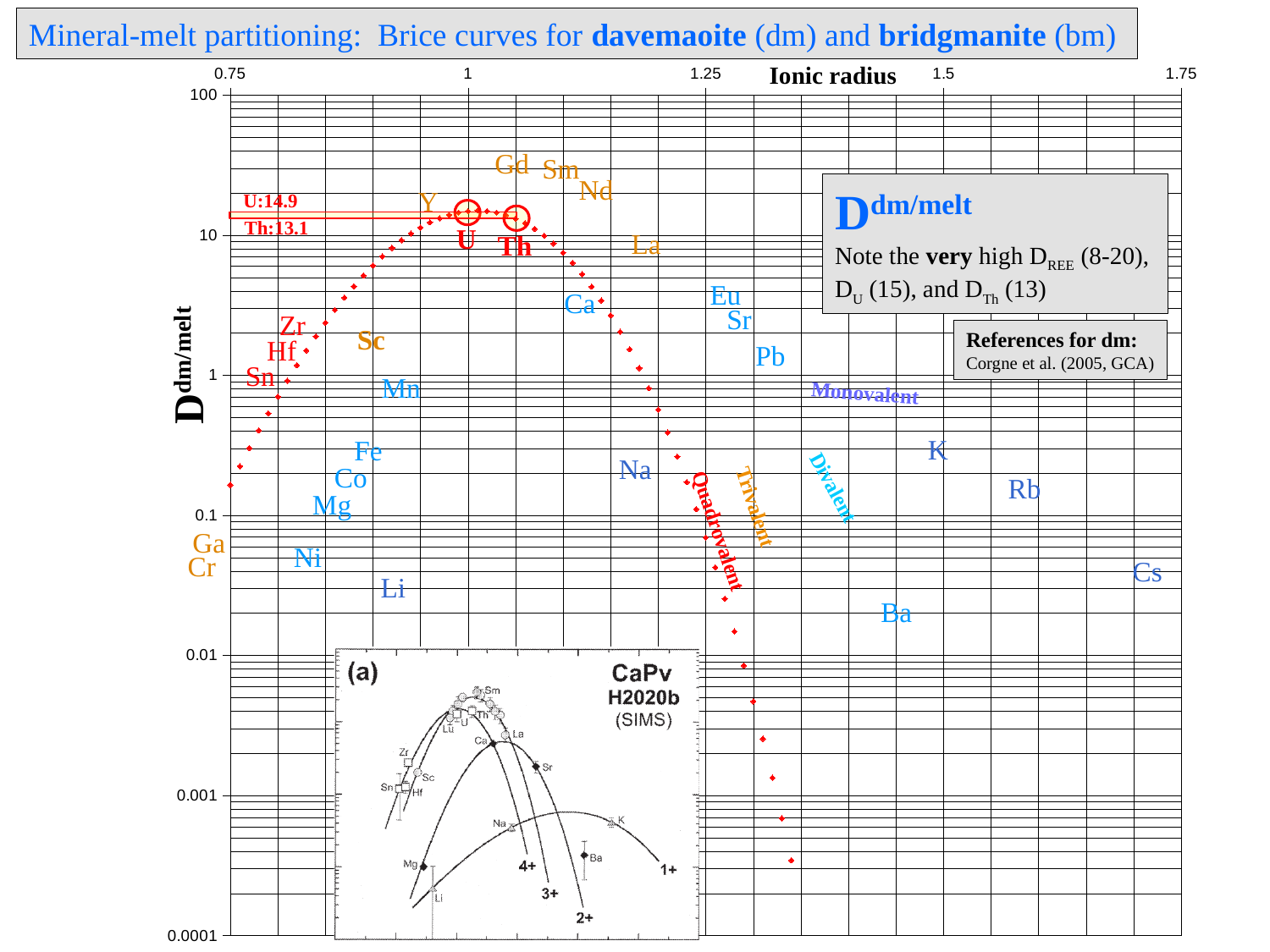
Is the value for Li greater or less than 0.1? less What value is printed for Th on the chart? 13.1 What is the label of the x axis? Ionic radius Do the red data points rise or fall as ionic radius increases beyond about 1.1? fall What is the difference between the printed D values for U (14.9) and Th (13.1)? 1.8 Which has the larger printed D value, U or Th? U Is the value for Ca greater or less than 1? greater What is the lowest value shown on the y axis? 0.0001 Is the value for Gd greater or less than 10? greater What value is printed for U on the chart? 14.9